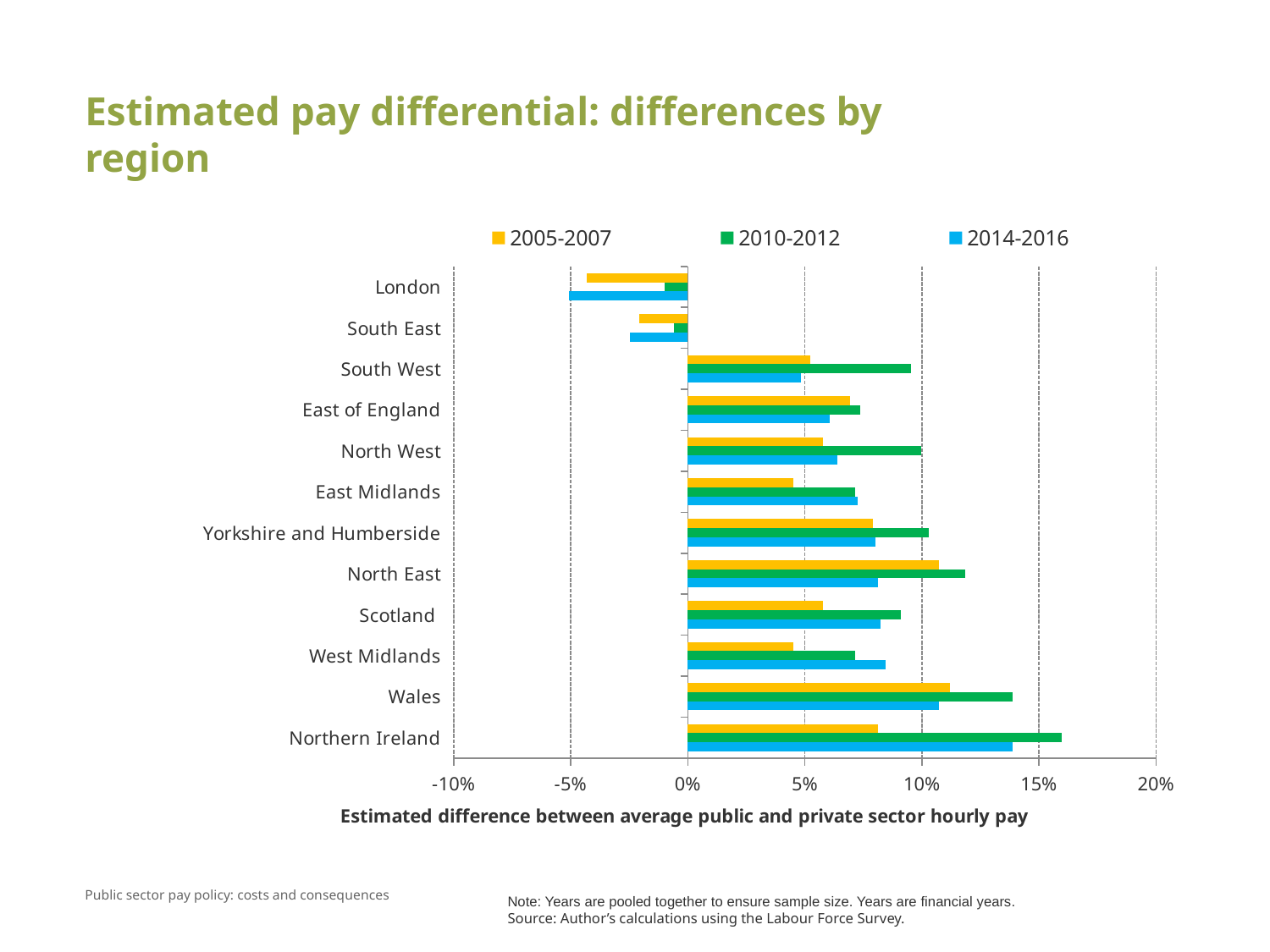
Is the 2010-2012 value for Northern Ireland greater or less than 15%? greater Which region has the lowest value for the 2014-2016 series? London What is the title of the horizontal axis? Estimated difference between average public and private sector hourly pay For the 2010-2012 series, which is larger: the value for Northern Ireland or the value for Wales? Northern Ireland Which region has the highest value for the 2014-2016 series? Northern Ireland Which region has the highest value for the 2010-2012 series? Northern Ireland Is the 2010-2012 value for Wales greater or less than 10%? greater What kind of chart is shown on the slide? bar chart Which region has the lowest value for the 2005-2007 series? London Is the 2014-2016 value for London greater or less than 0%? less How many series does the legend list? 3 How many regions are listed on the chart? 12